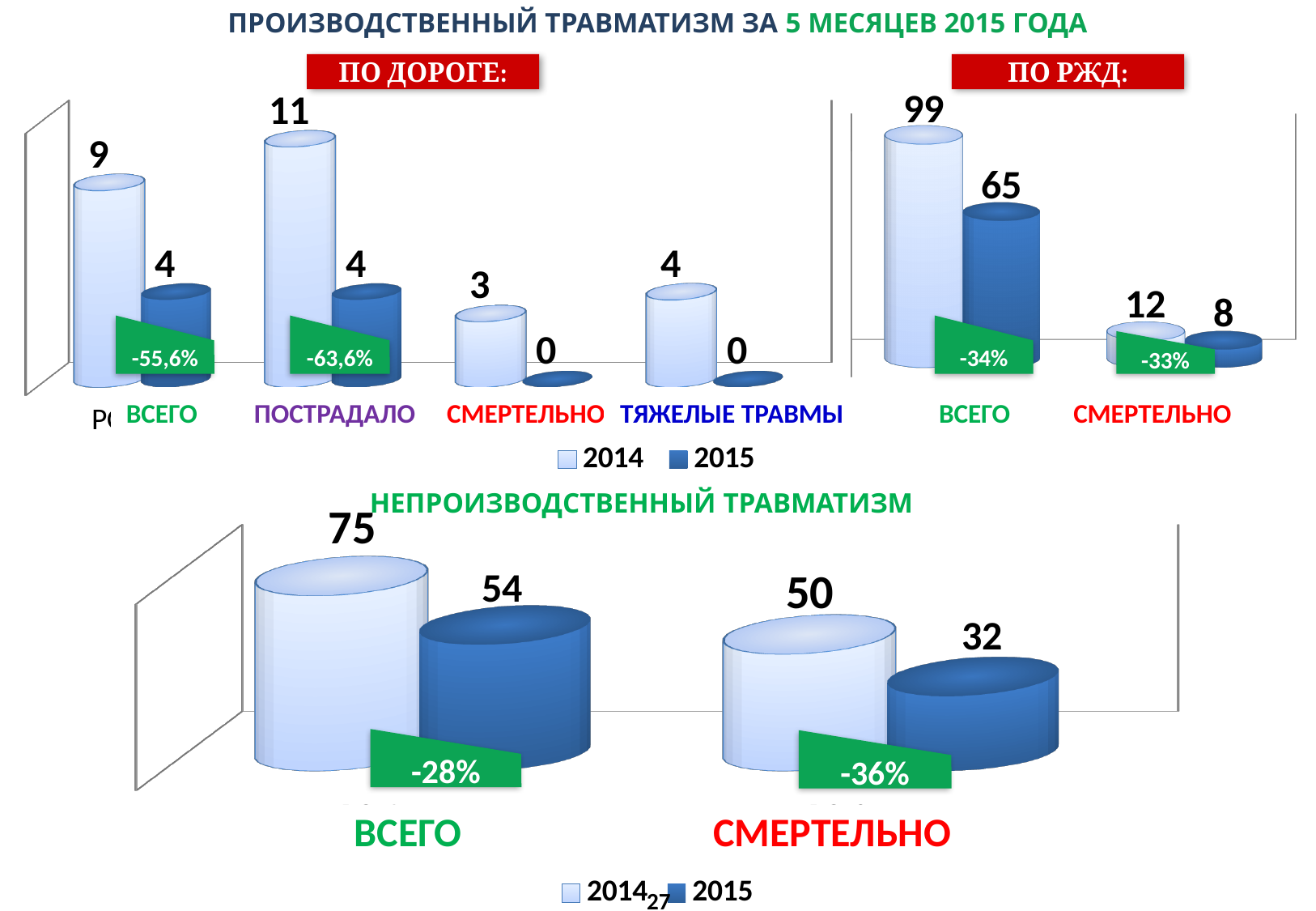
In the 'ПО ДОРОГЕ' chart, what is the 2015 value for ВСЕГО? 4 In the 'ПО РЖД' chart, what is the 2014 value for ВСЕГО? 99 In the 'ПО ДОРОГЕ' chart, how many categories are shown on the x axis? 4 In the 'НЕПРОИЗВОДСТВЕННЫЙ ТРАВМАТИЗМ' chart, what is the 2015 value for ВСЕГО? 54 In the 'ПО ДОРОГЕ' chart, what is the 2015 value for СМЕРТЕЛЬНО? 0 In the 'ПО ДОРОГЕ' chart, what is the 2014 value for ПОСТРАДАЛО? 11 In the 'ПО РЖД' chart, what is the difference between the 2014 and 2015 values for ВСЕГО? 34 In the 'НЕПРОИЗВОДСТВЕННЫЙ ТРАВМАТИЗМ' chart, what is the difference between the 2014 and 2015 values for СМЕРТЕЛЬНО? 18 What kind of chart is the 'НЕПРОИЗВОДСТВЕННЫЙ ТРАВМАТИЗМ' chart? Bar chart In the 'ПО РЖД' chart, which is larger for СМЕРТЕЛЬНО: the 2014 value or the 2015 value? 2014 How many series does the legend of the 'НЕПРОИЗВОДСТВЕННЫЙ ТРАВМАТИЗМ' chart list? 2 In the 'НЕПРОИЗВОДСТВЕННЫЙ ТРАВМАТИЗМ' chart, which category has the highest 2014 value? ВСЕГО